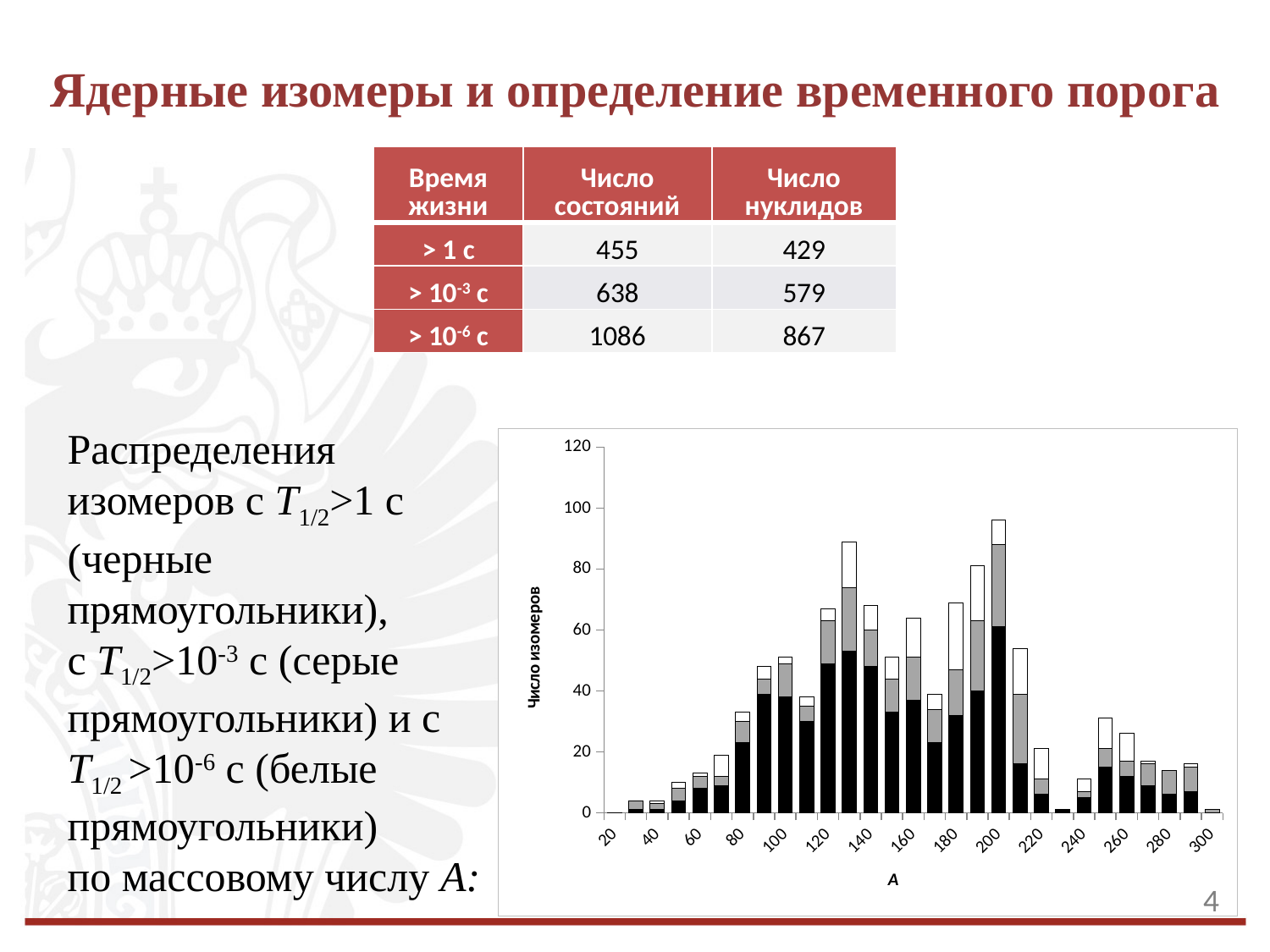
Is the total height of the bar at A = 20 greater or less than 20? less Is the total height of the bar at A = 300 greater or less than 20? less Is the total height of the bar at A = 200 greater or less than 80? greater Do the bar heights generally rise or fall as A goes from 200 to 300? fall What kind of chart is shown on the slide? bar chart Which bar is taller in total, the one at A = 200 or the one at A = 300? A = 200 Do the bar heights generally rise or fall as A goes from 20 to 120? rise What is the title of the vertical axis of the chart? Число изомеров Which bar is taller in total, the one at A = 60 or the one at A = 120? A = 120 What is the title of the horizontal axis of the chart? A